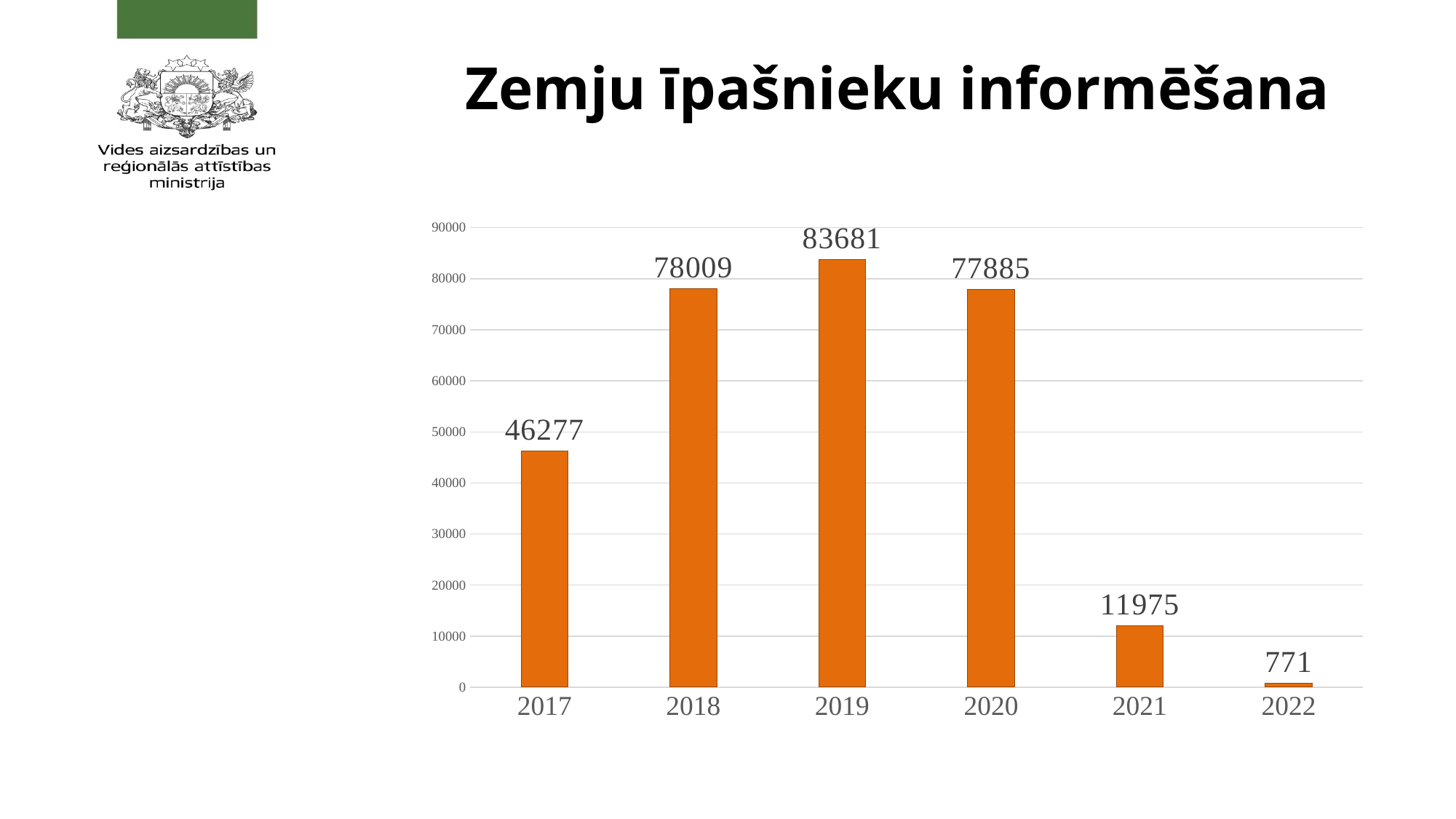
How many years are shown on the x axis? 6 Which year has the highest value? 2019 What is the value for 2017? 46277 Is the value for 2017 greater or less than 40000? greater Which year has the lowest value? 2022 Do the values rise or fall from 2020 to 2022? fall What is the difference between the values for 2019 and 2018? 5672 What kind of chart is shown on the slide? bar chart What is the value for 2022? 771 What is the value for 2019? 83681 Which is larger, the value for 2018 or the value for 2020? 2018 What is the difference between the values for 2021 and 2022? 11204